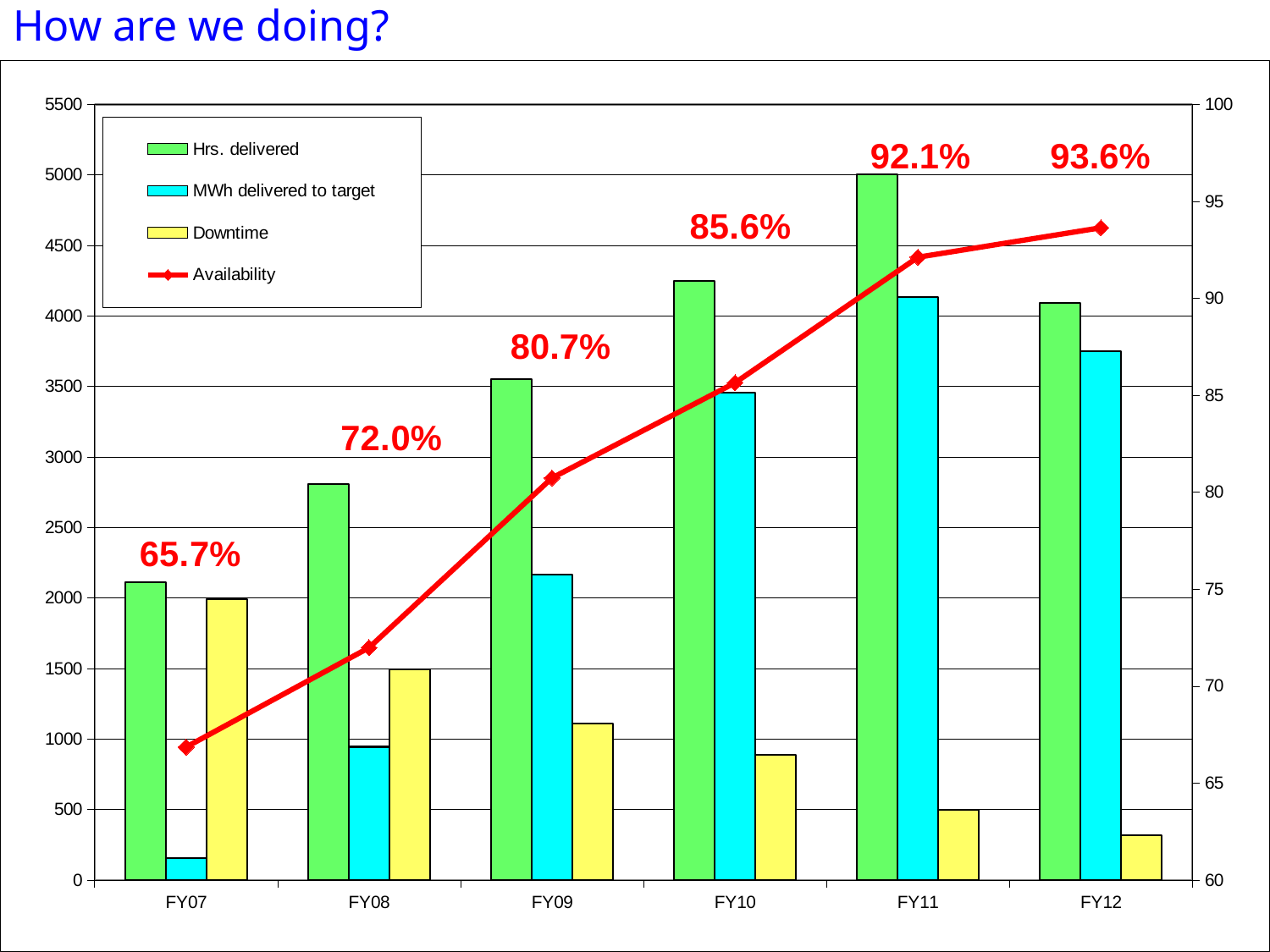
What is the Availability value for FY09? 80.7% In which fiscal year is Availability highest? FY12 Is the value for Hrs. delivered in FY11 greater or less than 4500? greater What is the difference between the Availability values for FY12 and FY11? 1.5% How many series does the legend list? 4 Which colour represents Downtime in the legend? yellow In which fiscal year is Availability lowest? FY07 Is the value for Downtime in FY07 greater or less than 1500? greater What is the Availability value for FY07? 65.7% Does Availability rise or fall from FY07 to FY12? rises In which fiscal year is Downtime highest? FY07 How many fiscal years are shown on the x axis? 6